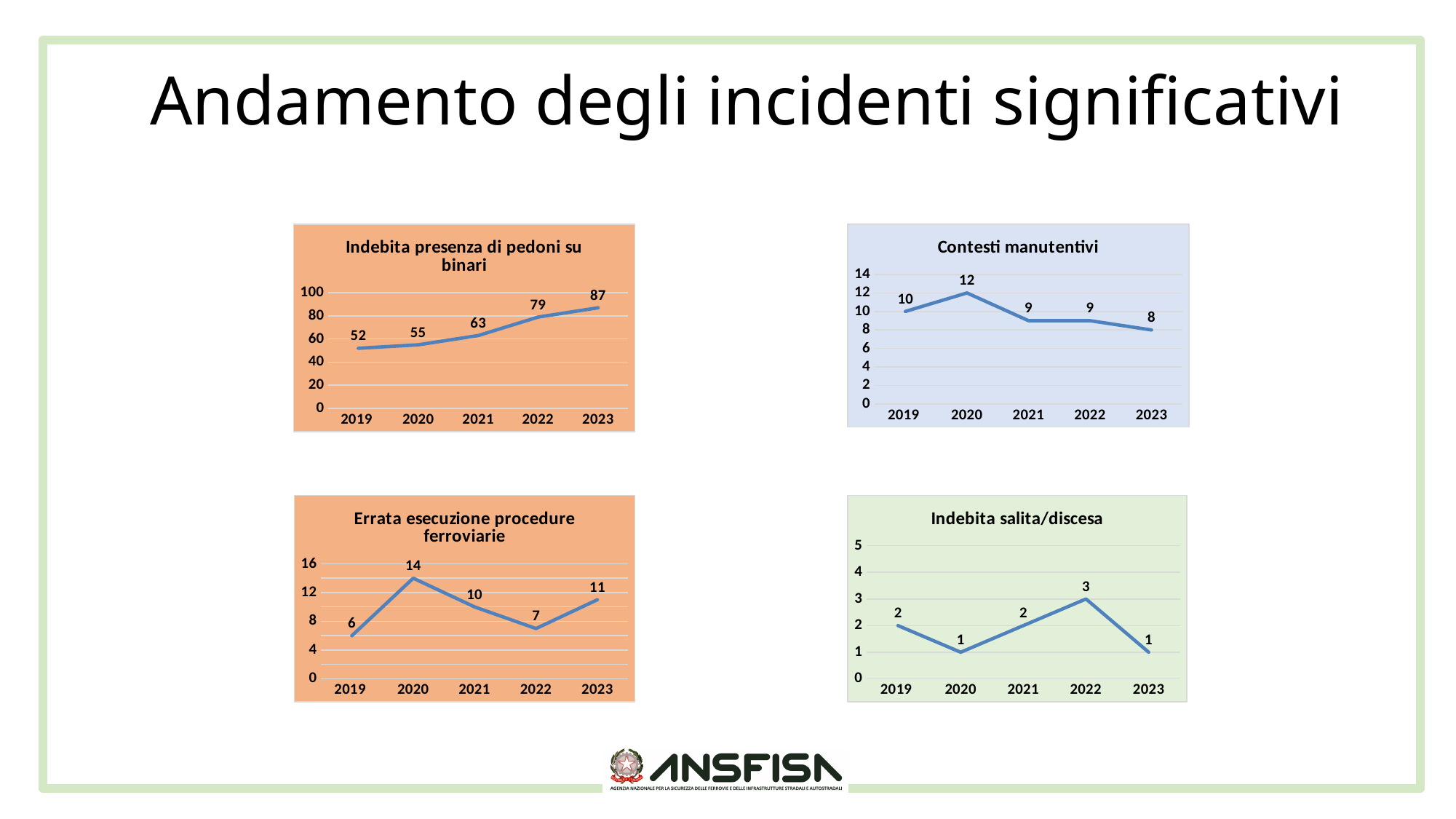
In the 'Contesti manutentivi' chart, which year has the lowest value? 2023 What kind of chart is the 'Contesti manutentivi' chart? line chart In the 'Indebita presenza di pedoni su binari' chart, what is the difference between the 2023 and 2019 values? 35 In the 'Indebita presenza di pedoni su binari' chart, what is the value for 2023? 87 In the 'Indebita salita/discesa' chart, what is the value for 2022? 3 In the 'Contesti manutentivi' chart, which year has the highest value? 2020 How many years are plotted on the x axis of the 'Indebita salita/discesa' chart? 5 In the 'Contesti manutentivi' chart, what is the value for 2023? 8 In the 'Errata esecuzione procedure ferroviarie' chart, what is the value for 2020? 14 In the 'Errata esecuzione procedure ferroviarie' chart, which year has the lowest value? 2019 In the 'Indebita presenza di pedoni su binari' chart, do the values rise or fall from 2019 to 2023? rise In the 'Errata esecuzione procedure ferroviarie' chart, is the value for 2021 larger than the value for 2022? Yes